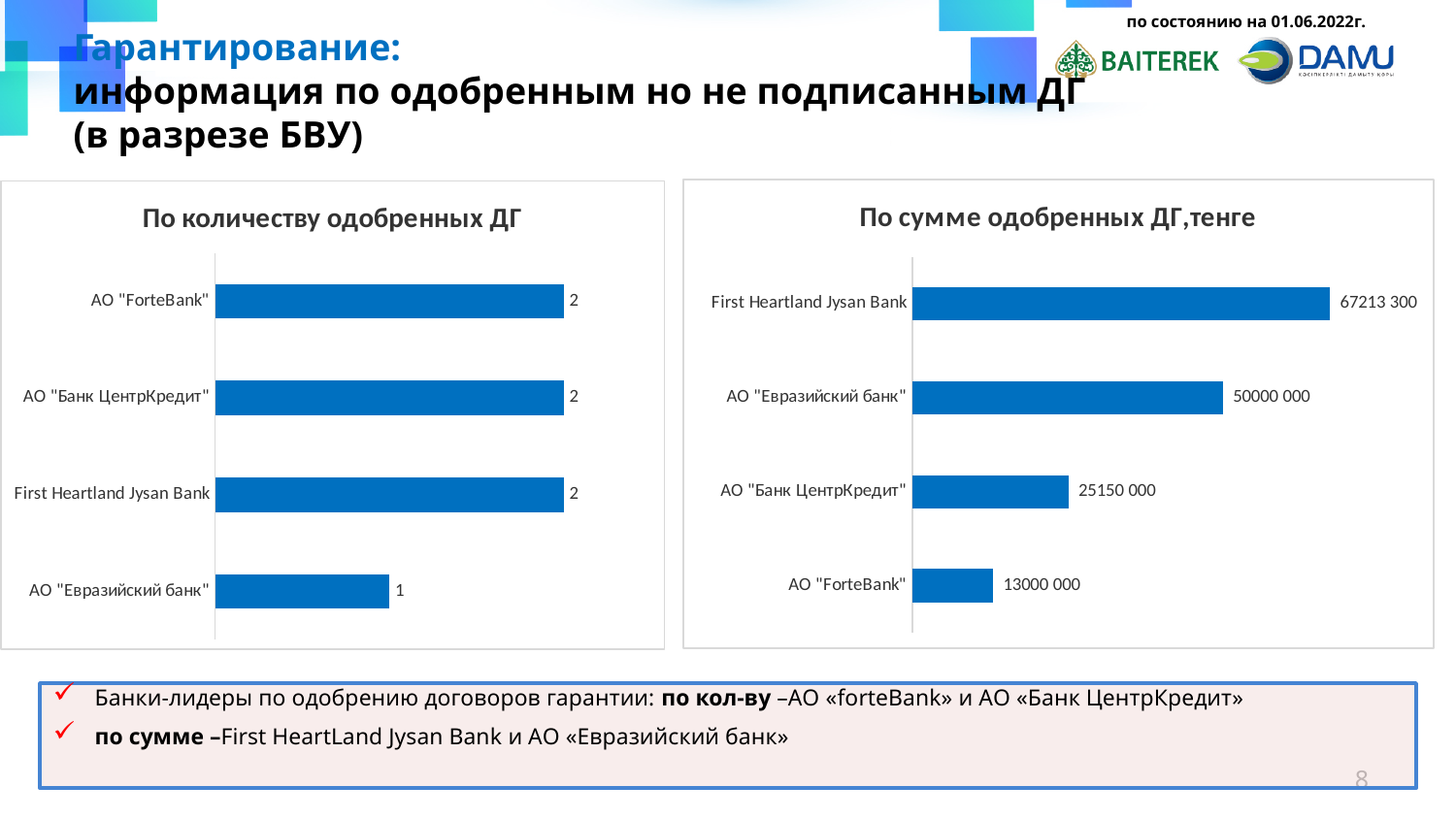
In the chart 'По количеству одобренных ДГ', what is the value for АО "Евразийский банк"? 1 In the chart 'По сумме одобренных ДГ,тенге', what is the value for АО "Банк ЦентрКредит"? 25150 000 In the chart 'По сумме одобренных ДГ,тенге', which bank has the lowest value? АО "ForteBank" In the chart 'По сумме одобренных ДГ,тенге', what is the difference between First Heartland Jysan Bank and АО "Евразийский банк"? 17213 300 In the chart 'По сумме одобренных ДГ,тенге', which bank has the highest value? First Heartland Jysan Bank In the chart 'По количеству одобренных ДГ', what is the value for АО "ForteBank"? 2 In the chart 'По количеству одобренных ДГ', how many banks are shown? 4 What is the title of the chart on the left side of the slide? По количеству одобренных ДГ In the chart 'По количеству одобренных ДГ', which bank has the lowest value? АО "Евразийский банк" In the chart 'По сумме одобренных ДГ,тенге', which is larger: АО "Евразийский банк" or АО "Банк ЦентрКредит"? АО "Евразийский банк" What type of chart is 'По сумме одобренных ДГ,тенге'? Bar chart In the chart 'По сумме одобренных ДГ,тенге', what is the value for First Heartland Jysan Bank? 67213 300